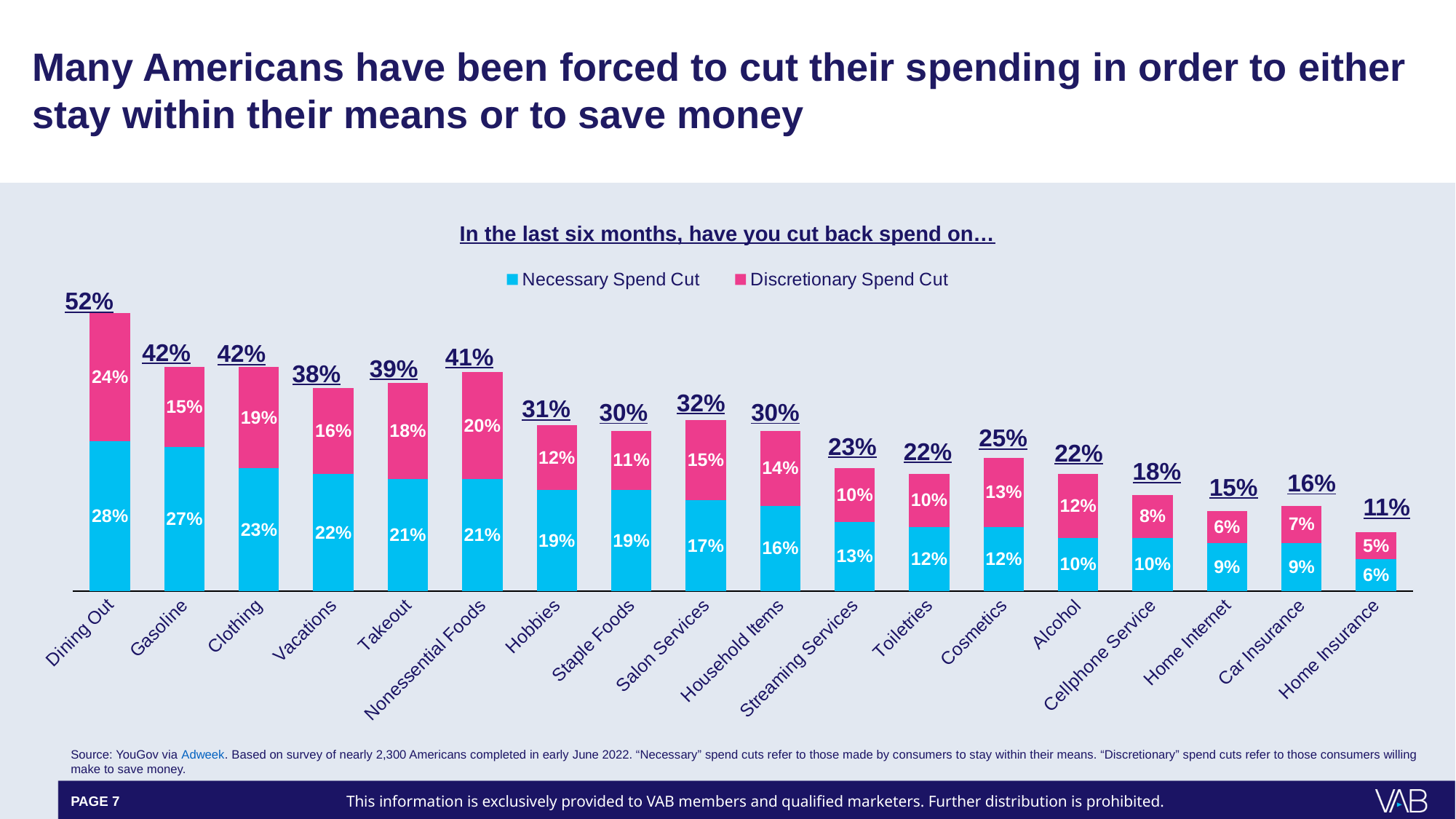
What is the Necessary Spend Cut value for Dining Out? 28% How many series does the legend list? 2 What is the Discretionary Spend Cut value for Salon Services? 15% Which category has the highest total cut-back percentage? Dining Out What is the Discretionary Spend Cut value for Nonessential Foods? 20% What is the title of the chart? In the last six months, have you cut back spend on… How many spending categories are shown on the x axis? 18 Which category has the lowest total cut-back percentage? Home Insurance Which is larger for Cosmetics: the Necessary Spend Cut or the Discretionary Spend Cut? Discretionary Spend Cut What is the total labelled above the Home Insurance bar? 11% What kind of chart is shown on the slide? Stacked bar chart What is the difference between the Necessary Spend Cut and Discretionary Spend Cut values for Gasoline? 12%